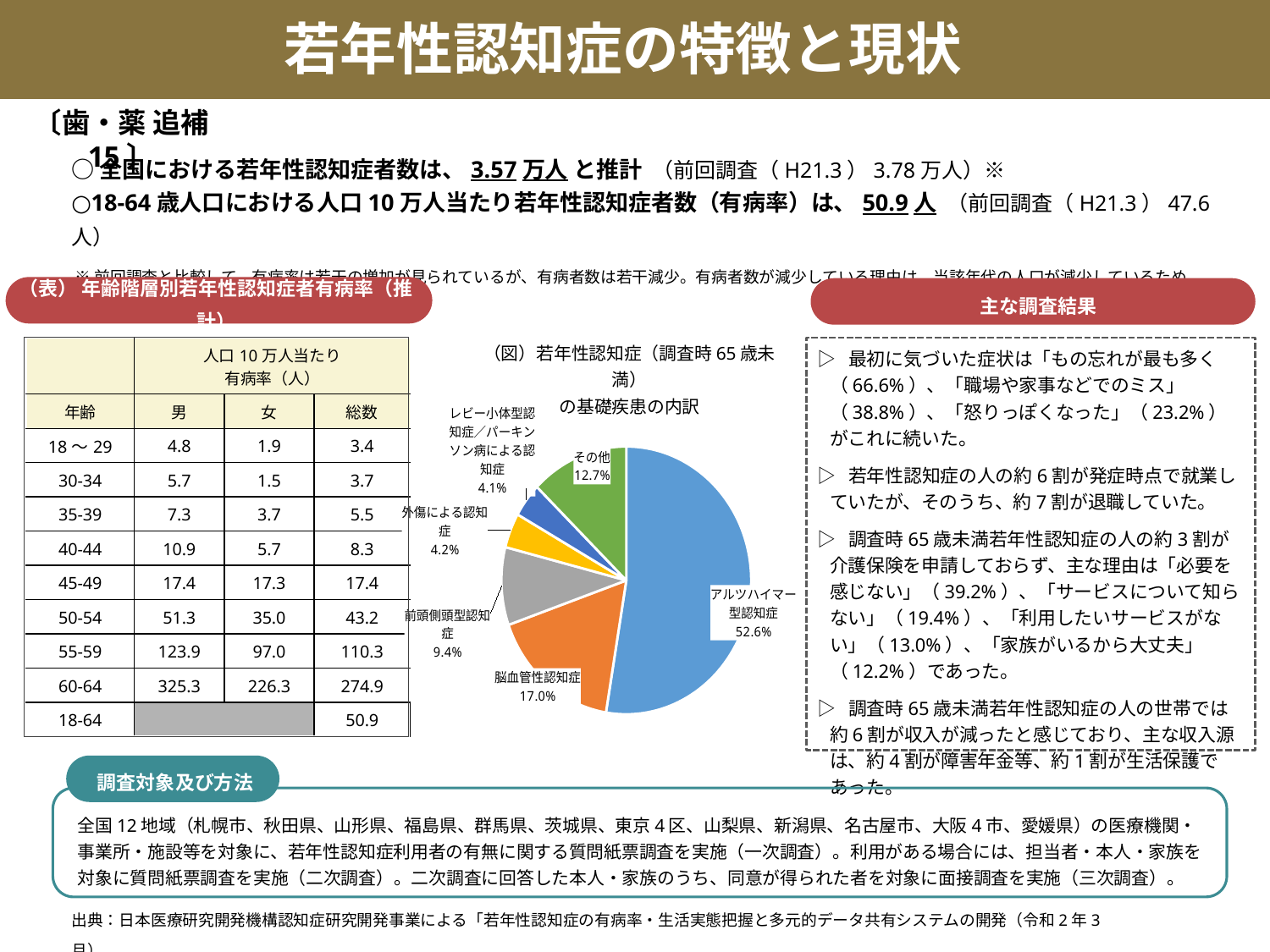
In the pie chart, what share is 外傷による認知症? 4.2% How many slices does the pie chart have? 6 In the pie chart, what is the difference between the shares of 脳血管性認知症 and 前頭側頭型認知症? 7.6% In the pie chart, what share is 脳血管性認知症? 17.0% In the pie chart, what share is アルツハイマー型認知症? 52.6% Which slice of the pie chart is the largest? アルツハイマー型認知症 What kind of chart is the figure titled 若年性認知症（調査時65歳未満）の基礎疾患の内訳? pie chart In the pie chart, which is larger: その他 or 脳血管性認知症? 脳血管性認知症 Which slice of the pie chart is the smallest? レビー小体型認知症／パーキンソン病による認知症